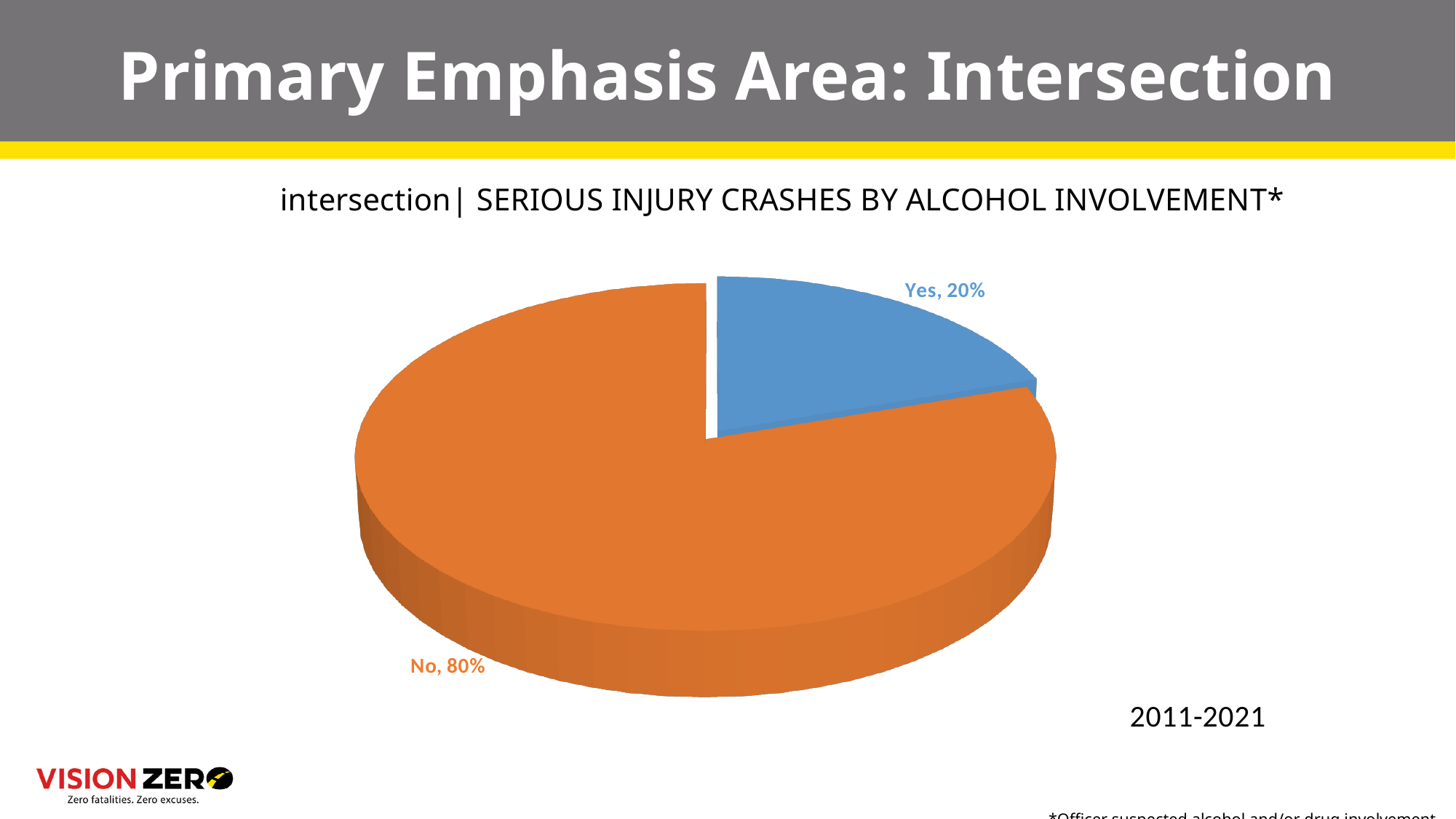
What share of intersection serious injury crashes involved alcohol (Yes)? 20% What time period does the chart cover? 2011-2021 How many slices does the pie chart have? 2 What kind of chart is shown on the slide? Pie chart Which slice of the pie is the smallest? Yes Which is larger, the Yes slice or the No slice? No Which slice of the pie is the largest? No What is the difference in percentage points between the No and Yes slices? 60 What share of intersection serious injury crashes did not involve alcohol (No)? 80% What colour is the Yes slice? Blue What is the title of the chart? intersection| SERIOUS INJURY CRASHES BY ALCOHOL INVOLVEMENT*